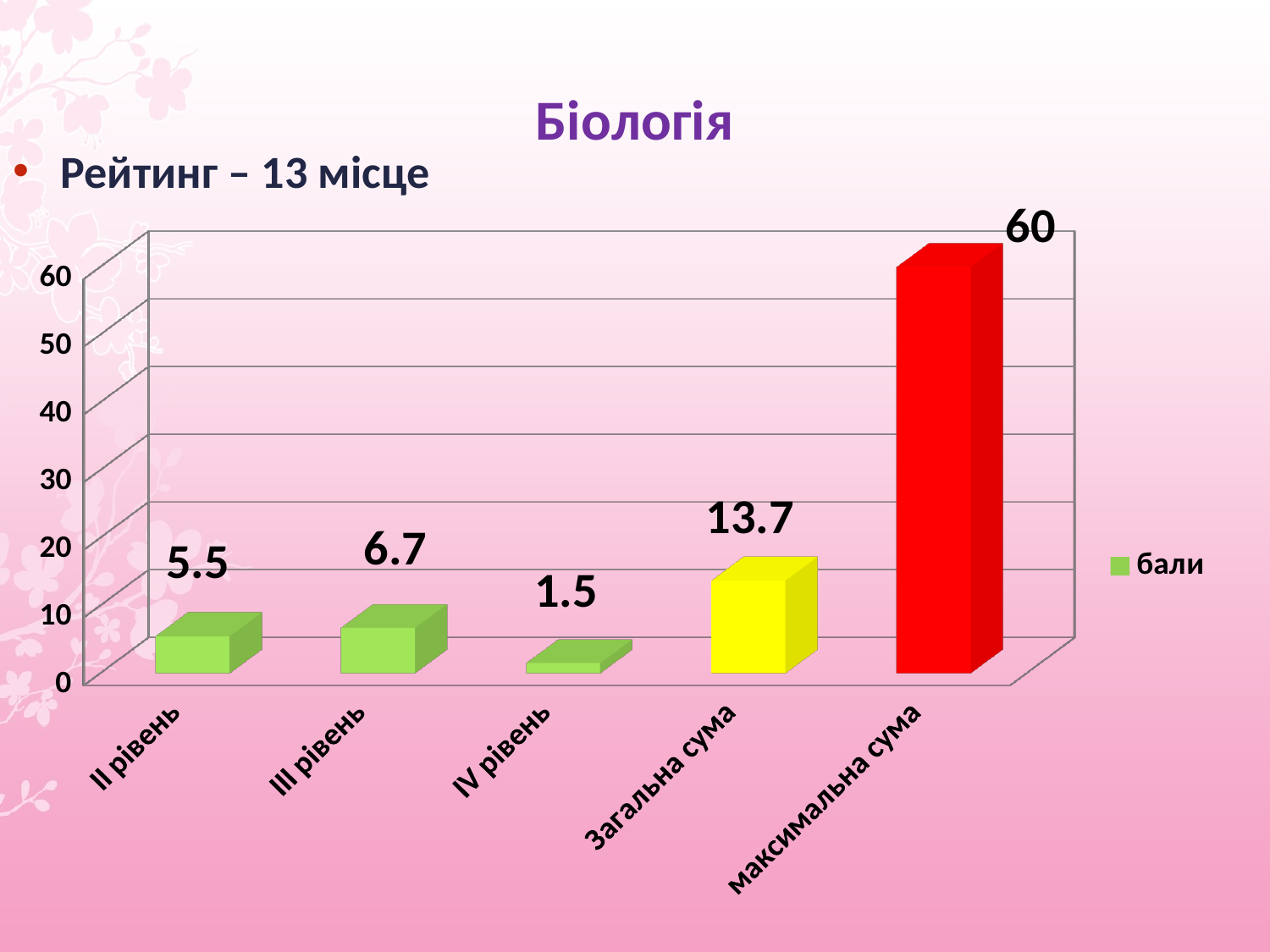
What is the value for IV рівень? 1.5 What kind of chart is shown on the slide? bar chart What is the value for максимальна сума? 60 How many categories are shown on the x axis? 5 What is the value for II рівень? 5.5 What series name does the legend show? бали Which is larger, the value for II рівень or the value for III рівень? III рівень What is the difference between the values for максимальна сума and Загальна сума? 46.3 Which category has the lowest value? IV рівень What is the value for III рівень? 6.7 Which category has the highest value? максимальна сума What is the value for Загальна сума? 13.7